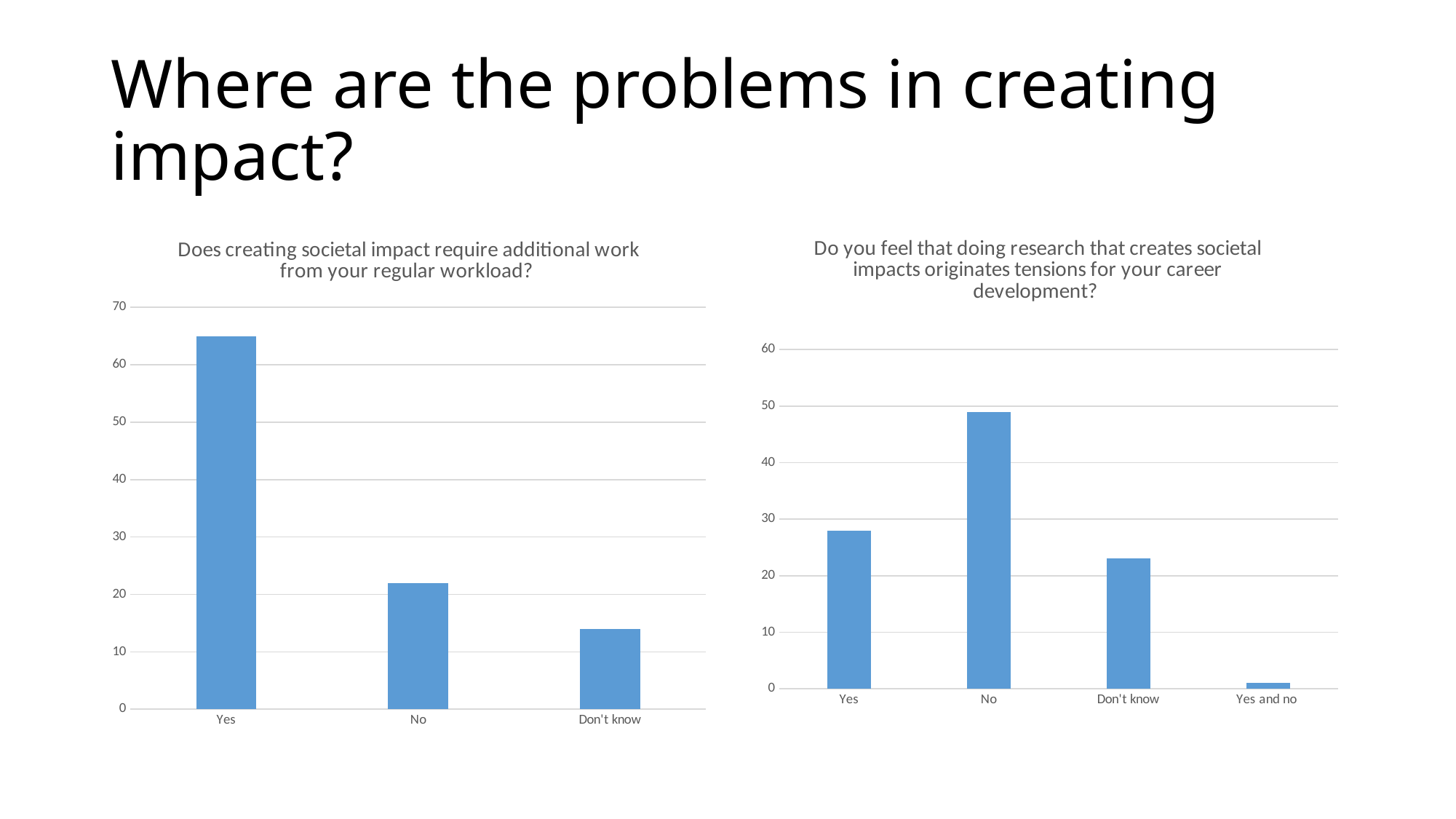
In the right chart, 'Do you feel that doing research that creates societal impacts originates tensions for your career development?', is the value for No greater or less than 40? greater In the right chart, 'Do you feel that doing research that creates societal impacts originates tensions for your career development?', is the value for Yes greater or less than 30? less What type of chart is the left chart, 'Does creating societal impact require additional work from your regular workload?'? bar chart In the right chart, 'Do you feel that doing research that creates societal impacts originates tensions for your career development?', which category has the lowest value? Yes and no In the left chart, 'Does creating societal impact require additional work from your regular workload?', which category has the highest value? Yes In the left chart, 'Does creating societal impact require additional work from your regular workload?', is the value for Yes greater or less than 60? greater In the right chart, 'Do you feel that doing research that creates societal impacts originates tensions for your career development?', which category has the highest value? No In the left chart, 'Does creating societal impact require additional work from your regular workload?', which category has the lowest value? Don't know In the right chart, 'Do you feel that doing research that creates societal impacts originates tensions for your career development?', which is larger, the value for Yes or the value for Don't know? Yes In the right chart, 'Do you feel that doing research that creates societal impacts originates tensions for your career development?', how many categories are shown on the x axis? 4 In the left chart, 'Does creating societal impact require additional work from your regular workload?', how many categories are shown on the x axis? 3